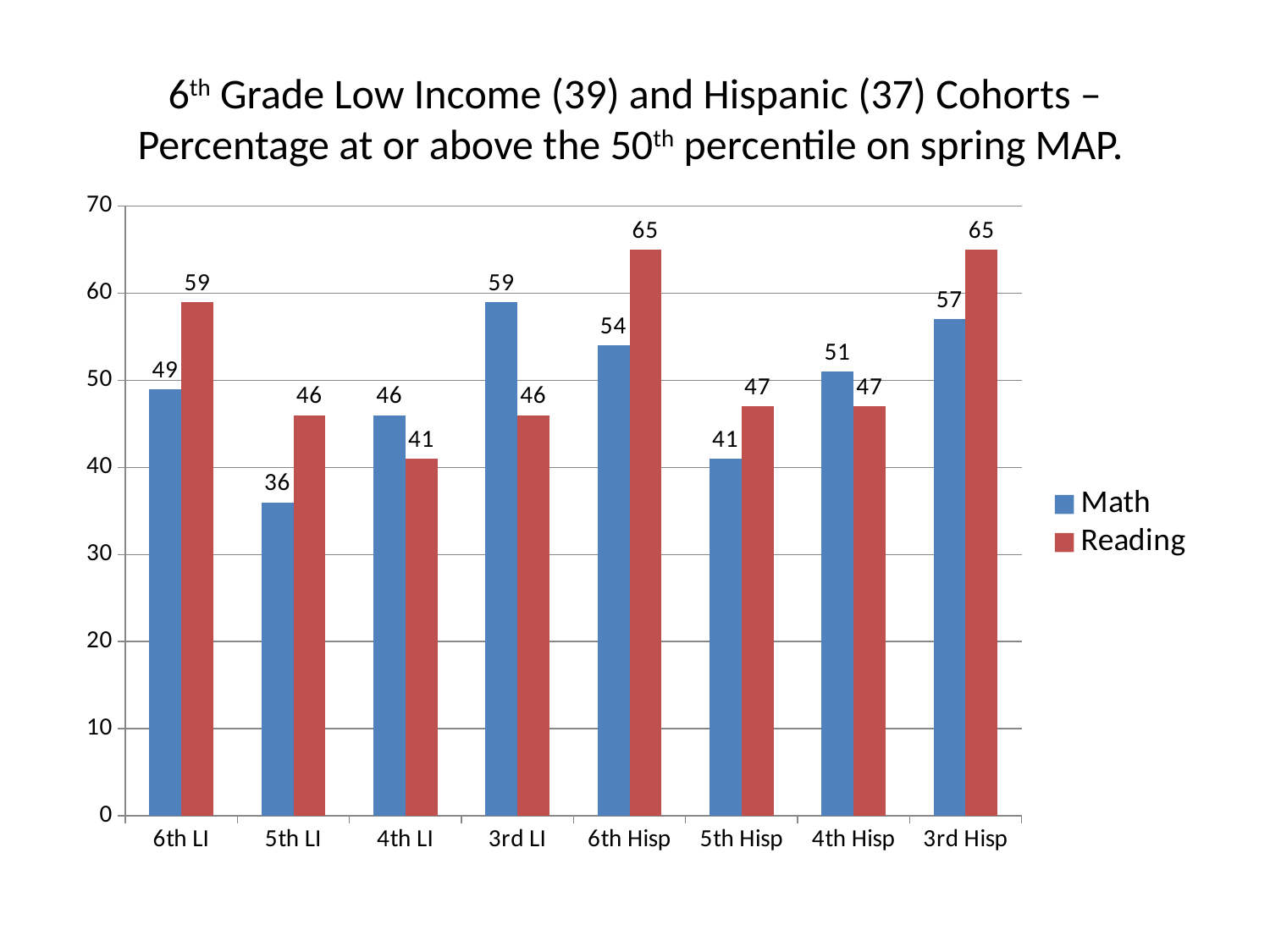
What is the Reading value for 6th Hisp? 65 How many categories are shown on the x axis? 8 What is the Math value for 5th LI? 36 Which category has the lowest Reading value? 4th LI How many series does the legend list? 2 Which is larger for 4th Hisp, the Math value or the Reading value? Math What is the difference between the Reading and Math values for 6th Hisp? 11 Which category has the lowest Math value? 5th LI What is the Math value for 3rd Hisp? 57 Which series is shown in red? Reading Which category has the highest Math value? 3rd LI What kind of chart is shown on the slide? Bar chart